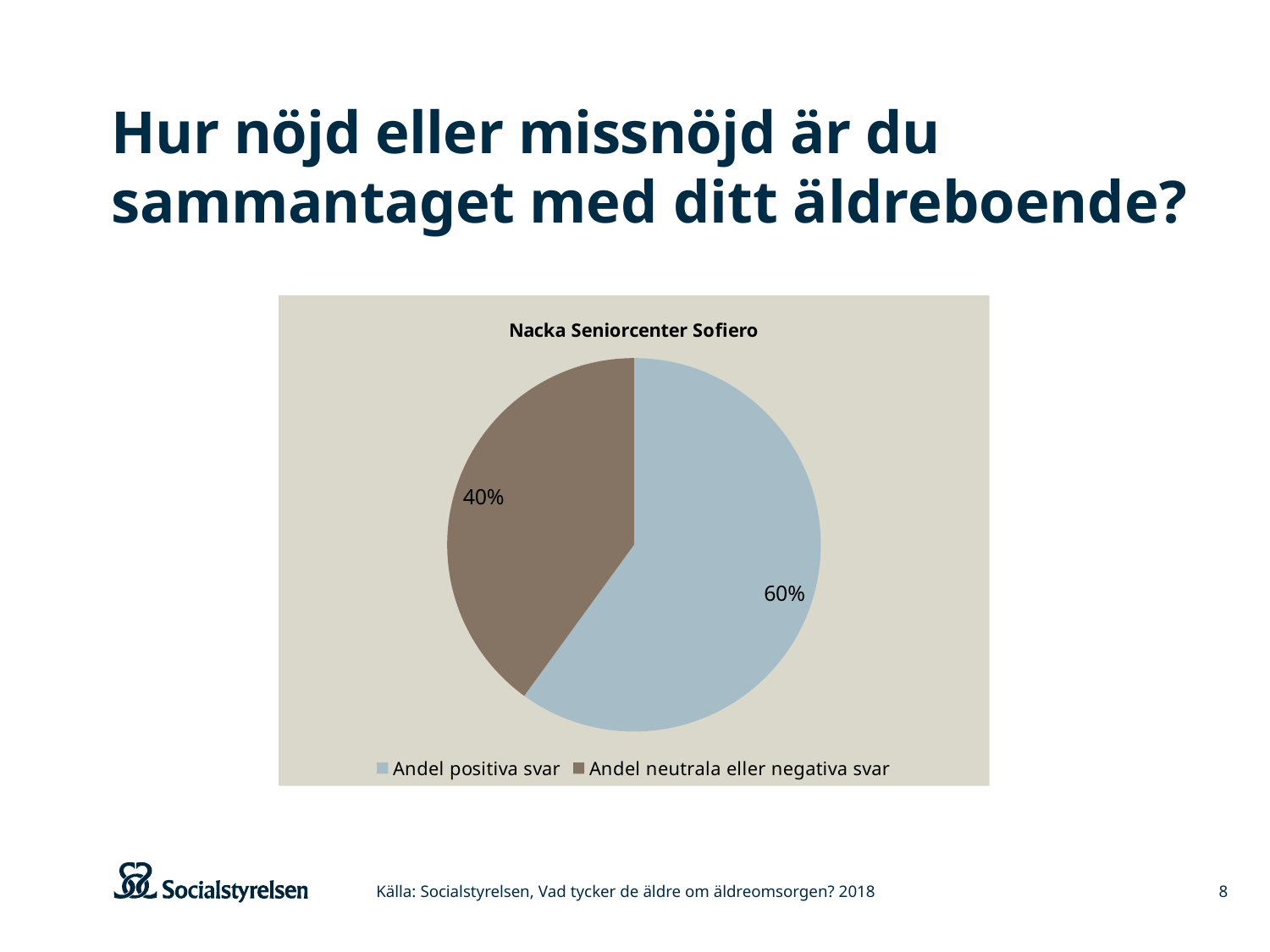
Which slice is the largest? Andel positiva svar How many entries does the legend list? 2 What is the title of the chart? Nacka Seniorcenter Sofiero Which is larger, 'Andel positiva svar' or 'Andel neutrala eller negativa svar'? Andel positiva svar What kind of chart is shown on the slide? pie chart What share of the pie is 'Andel neutrala eller negativa svar'? 40% Which legend entry is shown in brown? Andel neutrala eller negativa svar Which slice is the smallest? Andel neutrala eller negativa svar What share of the pie is 'Andel positiva svar'? 60% How many slices does the pie chart have? 2 What is the difference between the 'Andel positiva svar' slice and the 'Andel neutrala eller negativa svar' slice? 20%